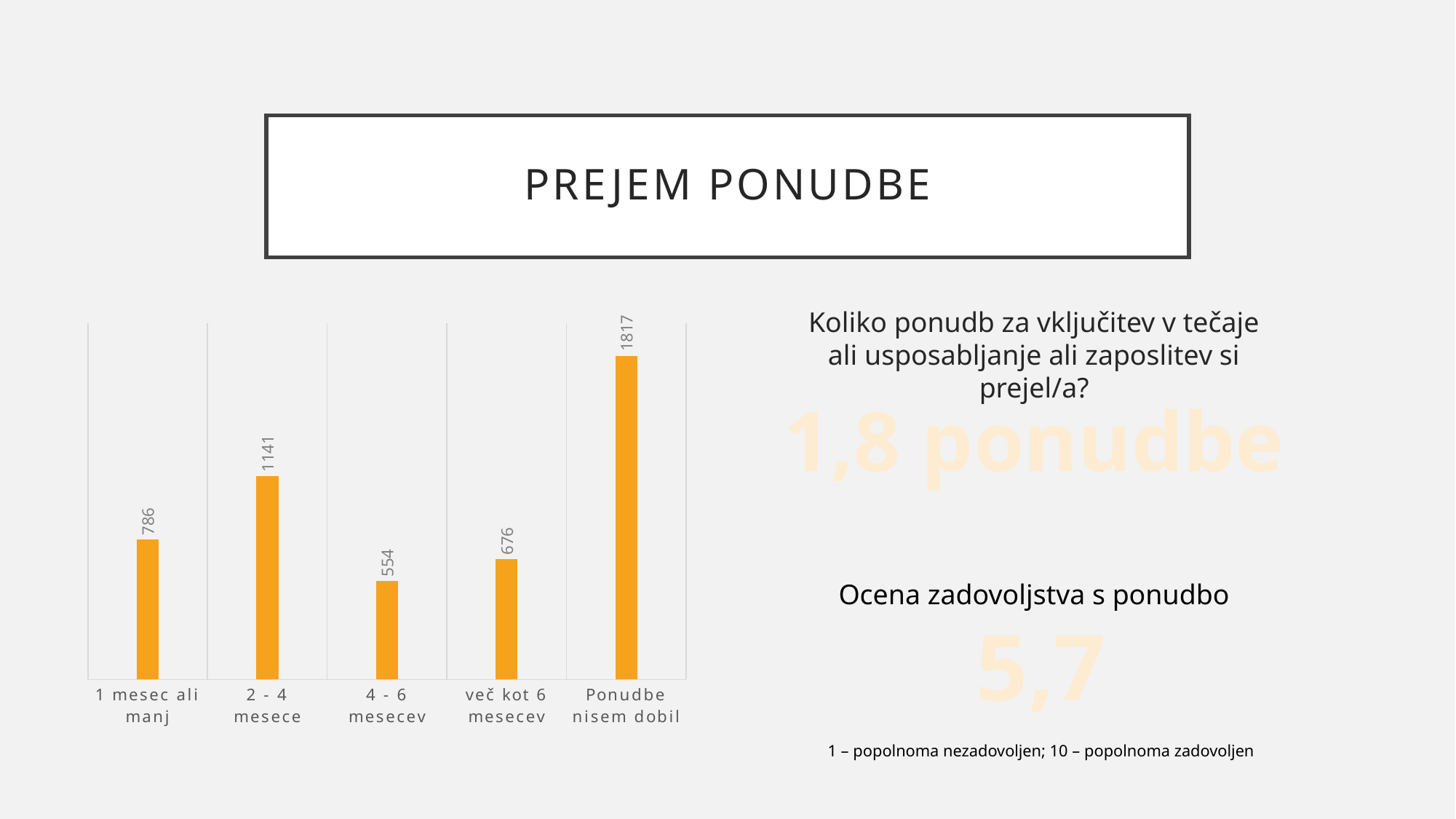
What kind of chart is shown on the slide? bar chart How many categories are shown in the chart? 5 What is the difference between the values for 'Ponudbe nisem dobil' and '2 - 4 mesece'? 676 What is the value for 'Ponudbe nisem dobil'? 1817 What is the difference between the values for '1 mesec ali manj' and 'več kot 6 mesecev'? 110 Which is larger, the value for '1 mesec ali manj' or the value for 'več kot 6 mesecev'? 1 mesec ali manj Which category has the highest value? Ponudbe nisem dobil What colour are the bars in the chart? orange What is the value for '2 - 4 mesece'? 1141 Which category has the lowest value? 4 - 6 mesecev What is the value for '1 mesec ali manj'? 786 What is the value for '4 - 6 mesecev'? 554